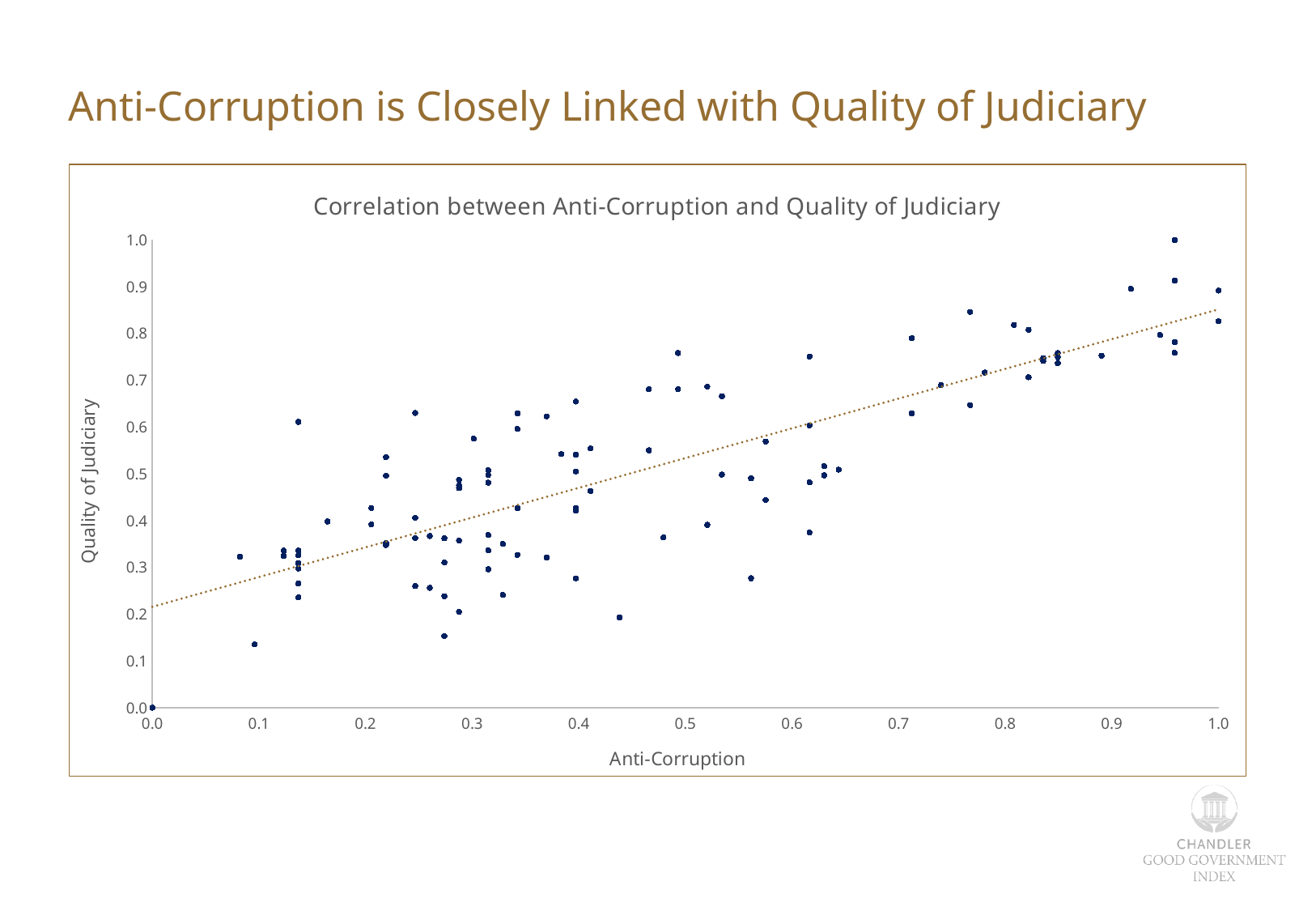
Is the highest Quality of Judiciary value plotted on the chart greater or less than 0.9? greater As Anti-Corruption increases along the x axis, does Quality of Judiciary generally rise or fall? Rise What is the title of the chart? Correlation between Anti-Corruption and Quality of Judiciary At Anti-Corruption 1.0, is the dotted trend line's value greater or less than 0.8? greater What kind of chart is shown on the slide? Scatter chart What is the maximum value shown on the Quality of Judiciary axis? 1.0 Is the lowest Quality of Judiciary value plotted on the chart greater or less than 0.1? less What variable is plotted on the vertical axis of the chart? Quality of Judiciary What is the maximum value shown on the Anti-Corruption axis? 1.0